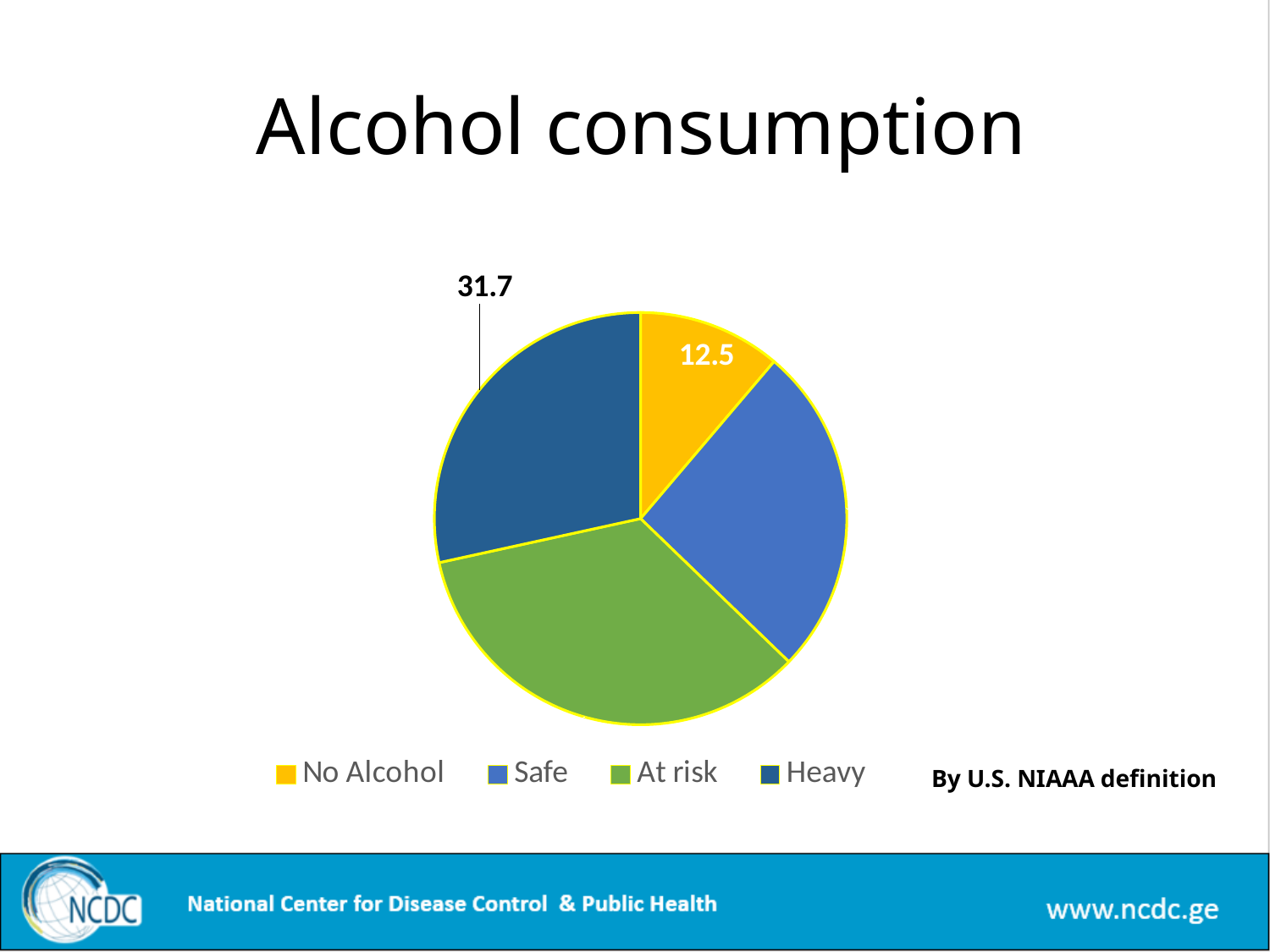
What is the title of the slide? Alcohol consumption What is the difference between the Heavy value and the No Alcohol value? 19.2 Which slice is larger, Heavy or Safe? Heavy What is the value shown for the No Alcohol slice? 12.5 What kind of chart is shown on the slide? Pie chart Which slice is larger, Safe or No Alcohol? Safe What is the value shown for the Heavy slice? 31.7 How many entries does the legend list? 4 How many categories does the pie chart show? 4 Which slice is larger, At risk or No Alcohol? At risk Which category has the smallest slice of the pie? No Alcohol What colour is the No Alcohol slice? Yellow